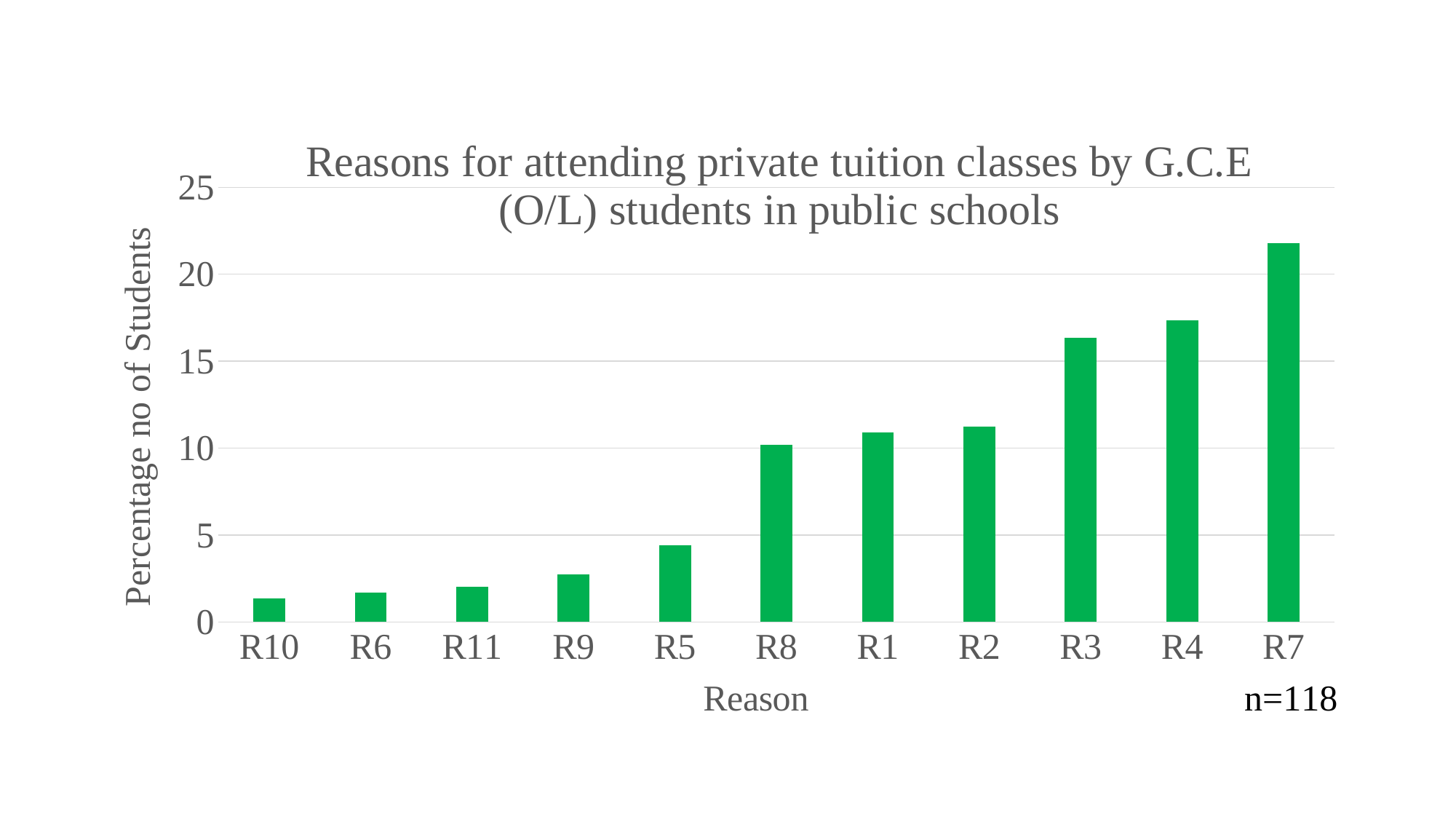
Which reason has the highest percentage of students? R7 Is the value for R7 greater or less than 20? greater Which is larger, the value for R4 or the value for R2? R4 What kind of chart is shown on the slide? bar chart How many reasons are plotted on the x axis? 11 What is the title of the chart? Reasons for attending private tuition classes by G.C.E (O/L) students in public schools Which reason has the lowest percentage of students? R10 Do the values rise or fall moving from left to right along the x axis? rise What is the label of the y axis? Percentage no of Students Is the value for R5 greater or less than 5? less Is the value for R3 greater or less than 15? greater